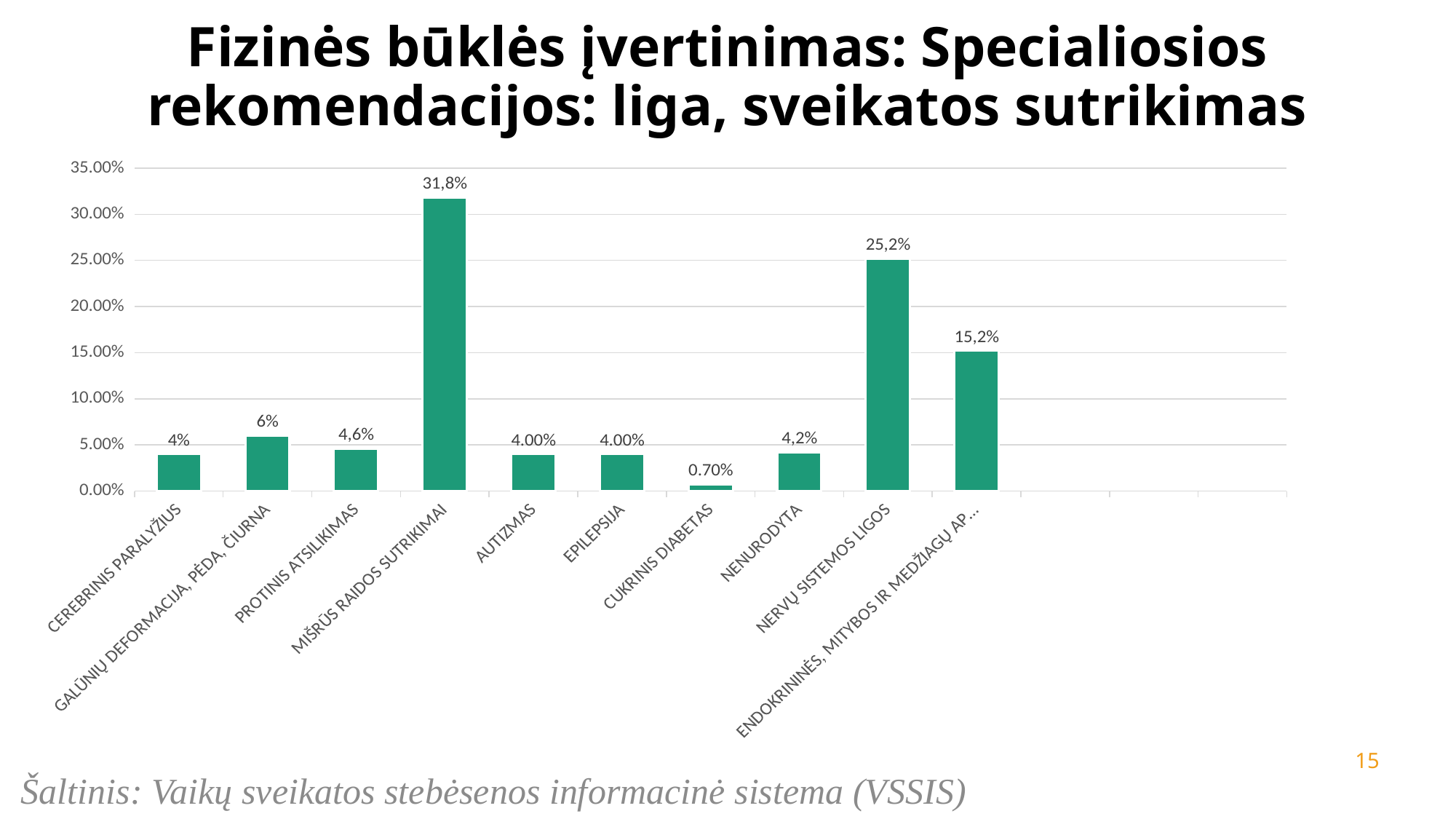
What kind of chart is shown on the slide? bar chart Which is larger, the value for NERVŲ SISTEMOS LIGOS or the value for PROTINIS ATSILIKIMAS? NERVŲ SISTEMOS LIGOS What is the value for MIŠRŪS RAIDOS SUTRIKIMAI? 31,8% Which category has the highest value? MIŠRŪS RAIDOS SUTRIKIMAI What is the value for GALŪNIŲ DEFORMACIJA, PĖDA, ČIURNA? 6% How many bars are plotted in the chart? 10 Which category has the lowest value? CUKRINIS DIABETAS What is the difference between the values for MIŠRŪS RAIDOS SUTRIKIMAI and NERVŲ SISTEMOS LIGOS? 6,6% What is the value for NERVŲ SISTEMOS LIGOS? 25,2% Is the value for MIŠRŪS RAIDOS SUTRIKIMAI greater or less than 30.00%? greater What is the value for CUKRINIS DIABETAS? 0.70% What is the value for NENURODYTA? 4,2%